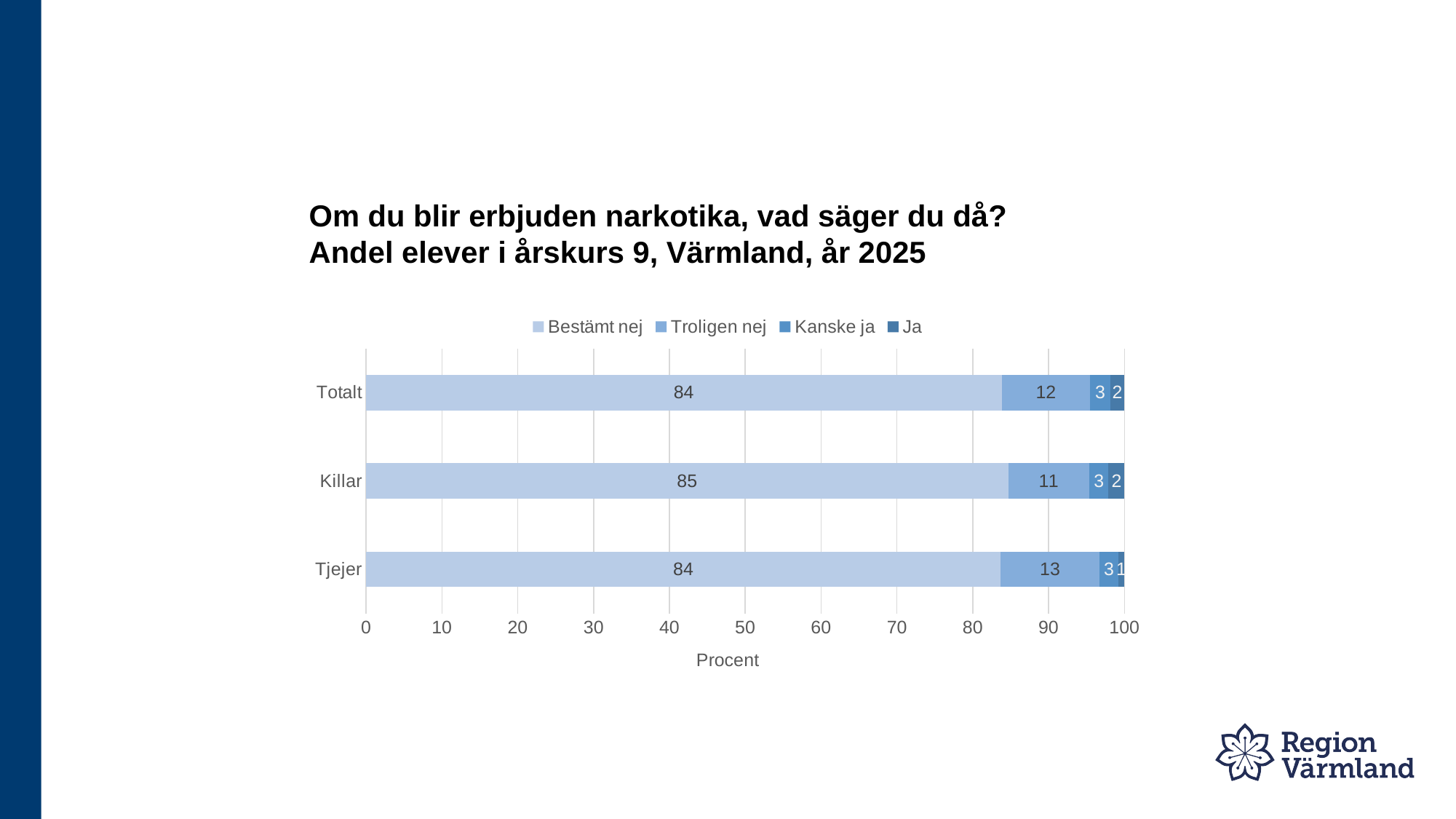
What is the value for Troligen nej for Tjejer? 13 How many series does the legend list? 4 What is the value for Ja for Totalt? 2 Which category has the highest value for Troligen nej? Tjejer Which category has the lowest value for Ja? Tjejer What is the difference between the Troligen nej values for Tjejer and Killar? 2 Which is larger, the Bestämt nej value for Killar or for Tjejer? Killar What is the value for Kanske ja for Killar? 3 What is the label of the x axis? Procent How many categories are shown on the y axis? 3 What is the value for Bestämt nej for Killar? 85 What kind of chart is shown on the slide? Stacked bar chart